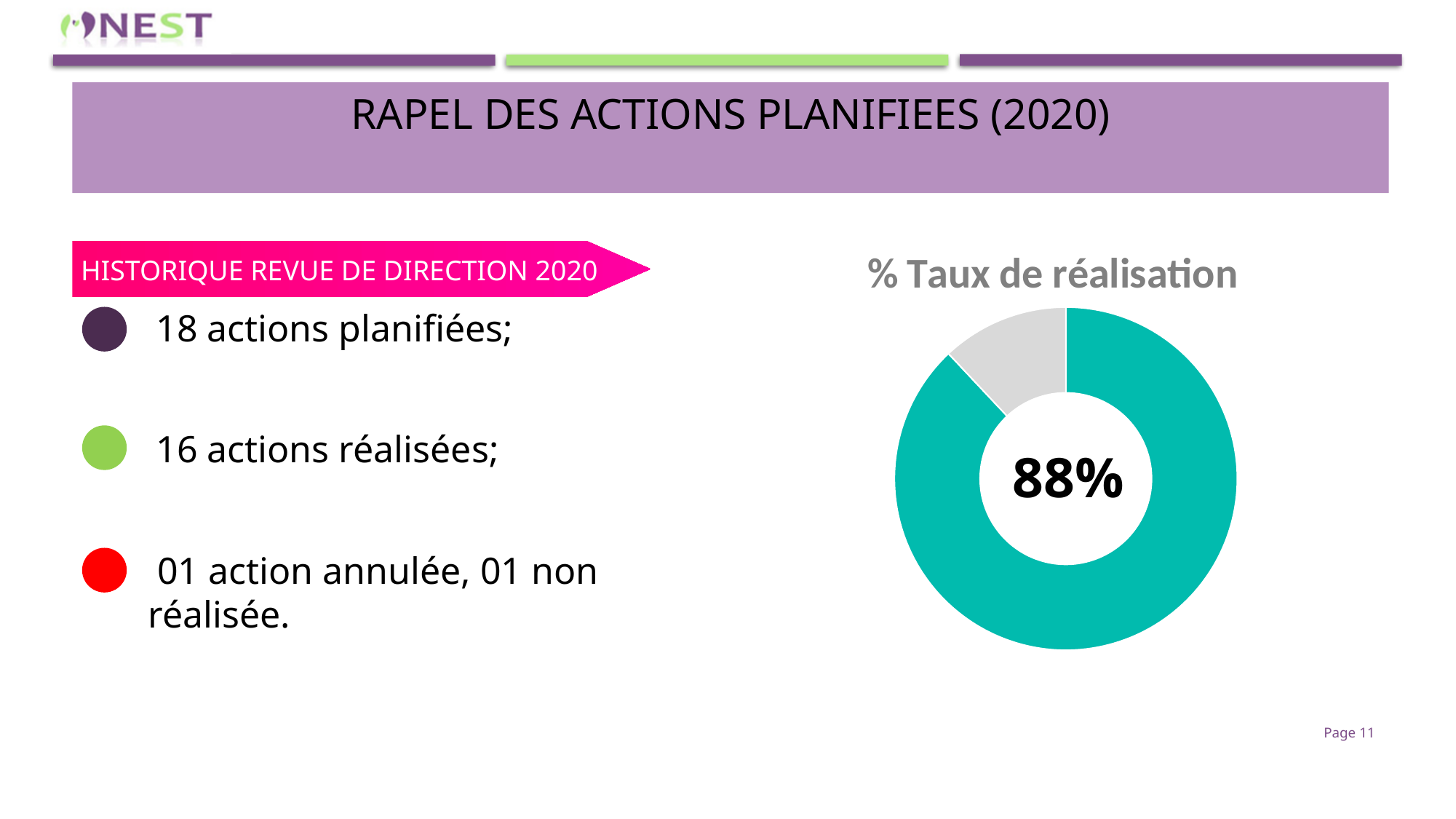
What kind of chart is shown on the slide? doughnut chart Which slice of the doughnut chart is larger, the teal one or the grey one? teal What percentage is printed in the centre of the doughnut chart? 88% How many slices does the doughnut chart have? 2 What colour is the largest slice of the doughnut chart? teal What is the title of the chart on the slide? % Taux de réalisation Which slice of the doughnut chart is the smallest? the grey slice What share of the doughnut chart does the teal slice represent? 88% Is the share of the teal slice in the doughnut chart greater or less than 50%? greater